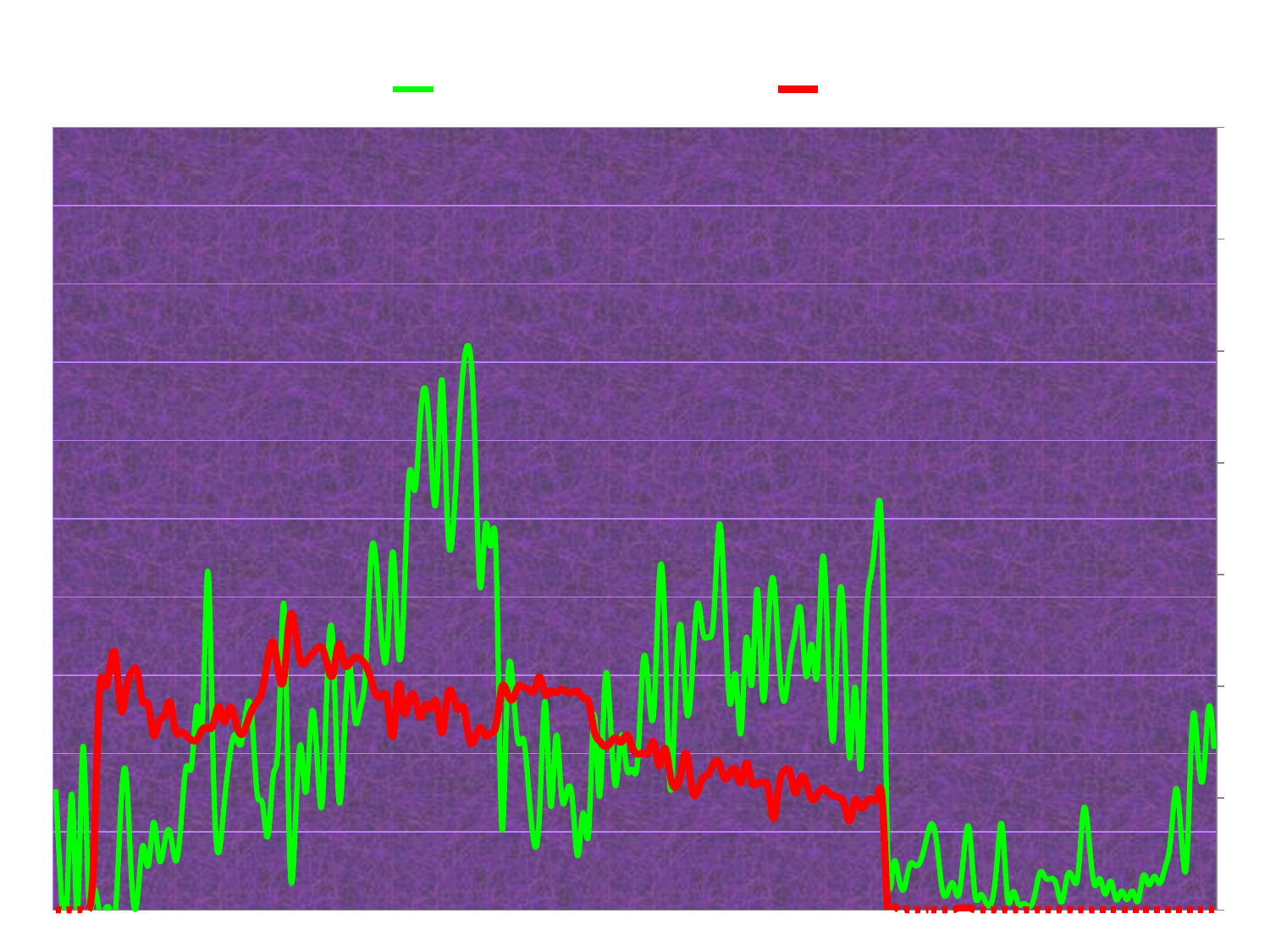
How many series does the legend list? 2 What kind of chart is shown on the slide? line chart Which line drops to the bottom of the chart and stays there for the right-hand portion of the x axis? red What colours are the two lines plotted on the chart? green and red Which line reaches the higher peak on the chart, the green line or the red line? green